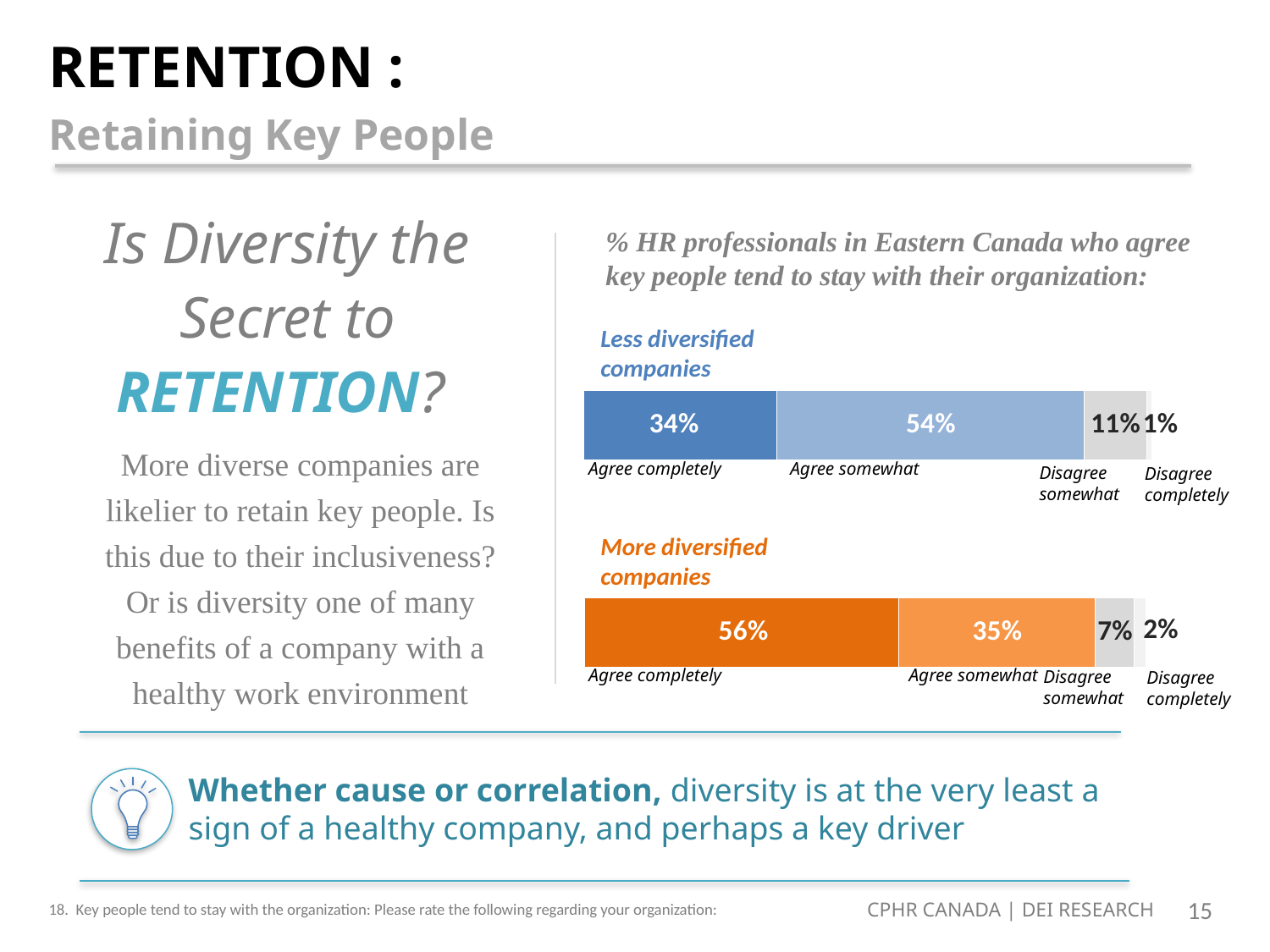
Which group has a higher 'Agree somewhat' percentage: less diversified companies or more diversified companies? Less diversified companies In the 'Less diversified companies' chart, what percentage disagree somewhat? 11% What kind of chart is used to show the responses for less and more diversified companies? Stacked bar chart What colour is used for the 'More diversified companies' bar? Orange In the 'More diversified companies' chart, what percentage agree somewhat? 35% How many response categories are shown in the 'More diversified companies' chart? 4 In the 'Less diversified companies' chart, what is the combined percentage of 'Agree completely' and 'Agree somewhat'? 88% In the 'Less diversified companies' chart, which response category has the largest share? Agree somewhat What is the difference between the 'Agree completely' percentages for more diversified companies (56%) and less diversified companies (34%)? 22 percentage points In the 'More diversified companies' chart, which response category has the smallest share? Disagree completely In the 'More diversified companies' chart, what percentage disagree completely? 2% In the 'Less diversified companies' chart, what percentage of HR professionals agree completely that key people tend to stay? 34%